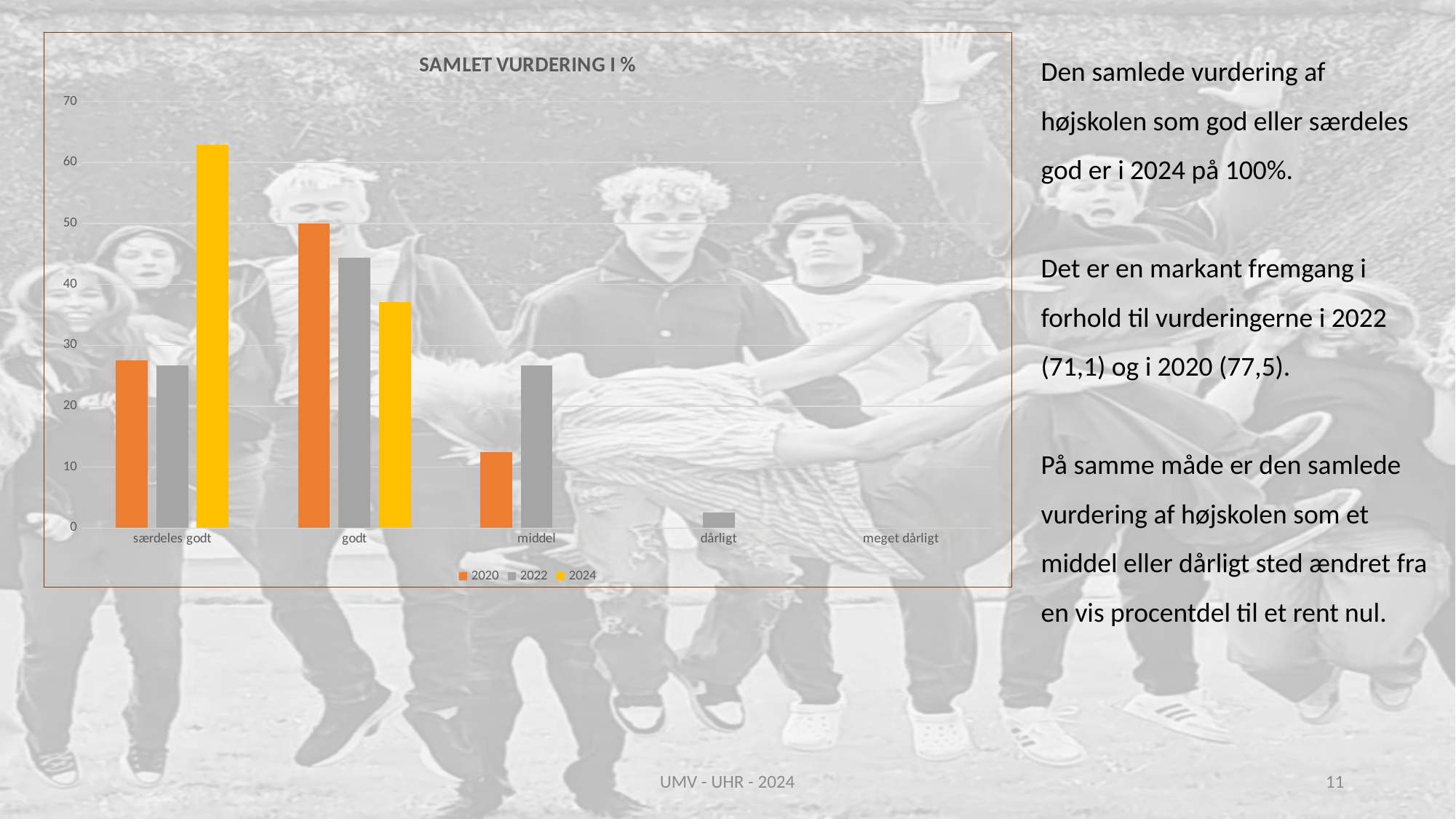
What is the title of the chart? SAMLET VURDERING I % What kind of chart is shown on the slide? bar chart Is the 2024 value for særdeles godt greater or less than 60? greater Which category has the highest value for the 2024 series? særdeles godt Is the 2024 value for godt greater or less than 40? less Is the 2022 value for godt greater or less than 40? greater Do the 2024 values rise or fall from særdeles godt to godt? fall For the 2024 series, which is larger: særdeles godt or godt? særdeles godt For the godt category, which is larger: the 2020 value or the 2022 value? 2020 How many series does the legend of the chart list? 3 How many categories are shown on the x axis of the chart? 5